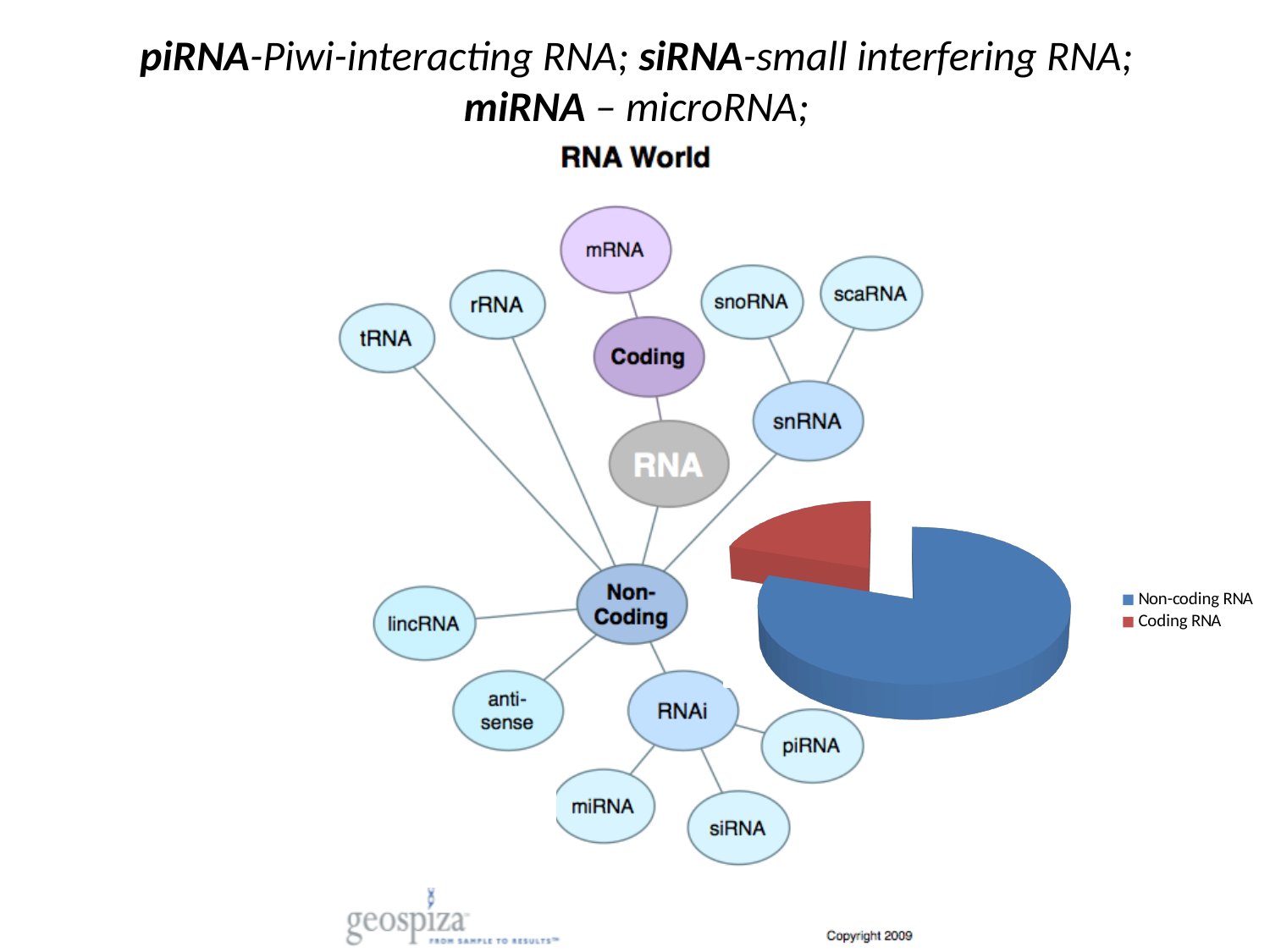
What colour is the Coding RNA slice in the pie chart? red How many slices does the pie chart have? 2 Which slice is larger in the pie chart, Non-coding RNA or Coding RNA? Non-coding RNA Which category has the largest slice in the pie chart? Non-coding RNA What kind of chart is shown on the slide? pie chart How many entries does the pie chart's legend list? 2 What colour is the Non-coding RNA slice in the pie chart? blue Which category has the smallest slice in the pie chart? Coding RNA